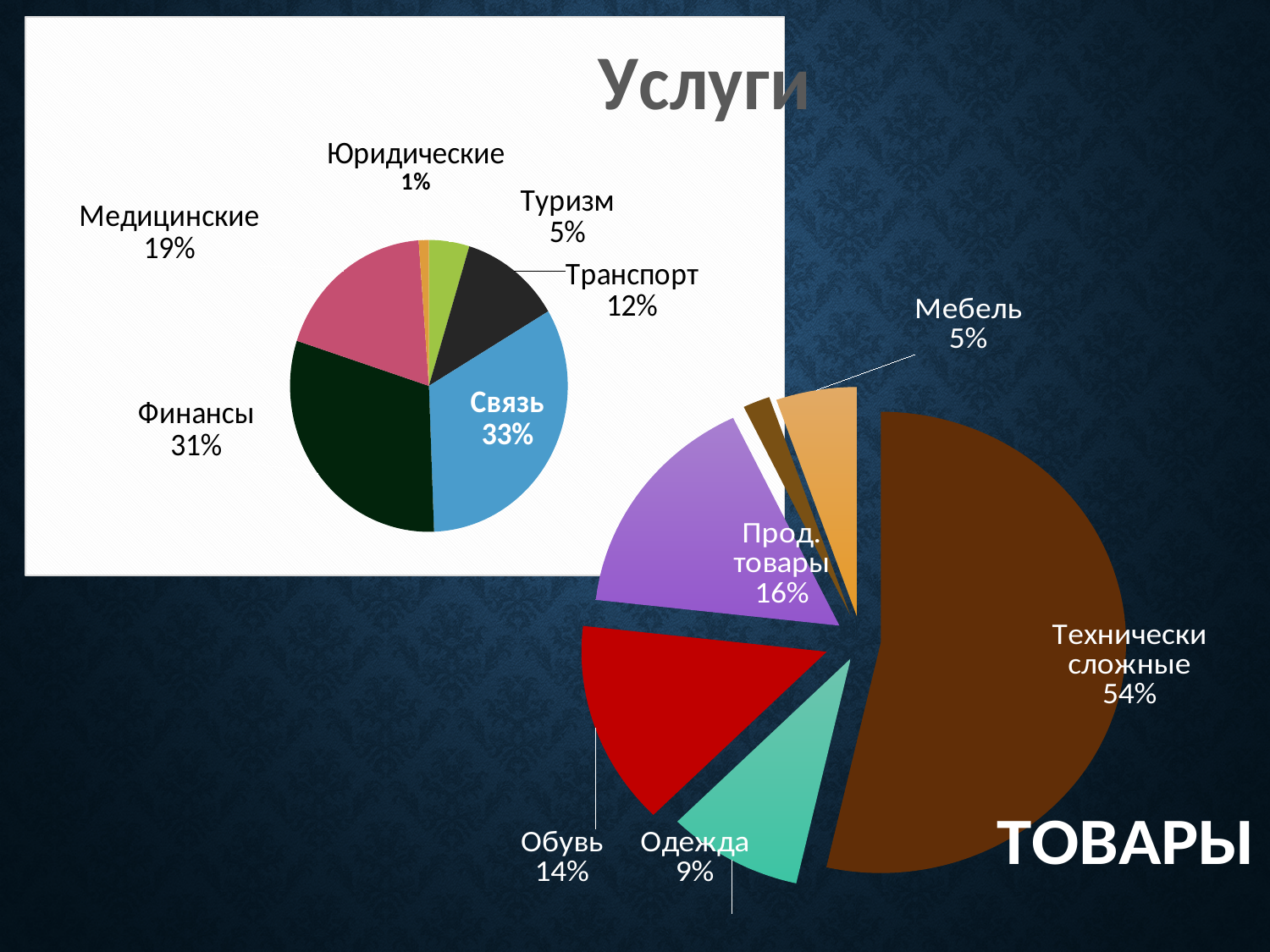
In the "Товары" chart, which labelled category has the largest share? Технически сложные In the "Товары" chart, what share does Одежда have? 9% In the "Товары" chart, what share does Технически сложные have? 54% In the "Услуги" chart, what is the difference between the shares of Финансы and Транспорт? 19% In the "Услуги" chart, which labelled category has the smallest share? Юридические In the "Товары" chart, what is the difference between the shares of Прод. товары and Мебель? 11% In the "Услуги" chart, what share does Медицинские have? 19% In the "Услуги" chart, what share does Связь have? 33% In the "Услуги" chart, which labelled category has the largest share? Связь In the "Товары" chart, which is larger: Обувь or Одежда? Обувь What type of chart is the "Товары" chart? Pie chart In the "Услуги" chart, which is larger: Туризм or Транспорт? Транспорт